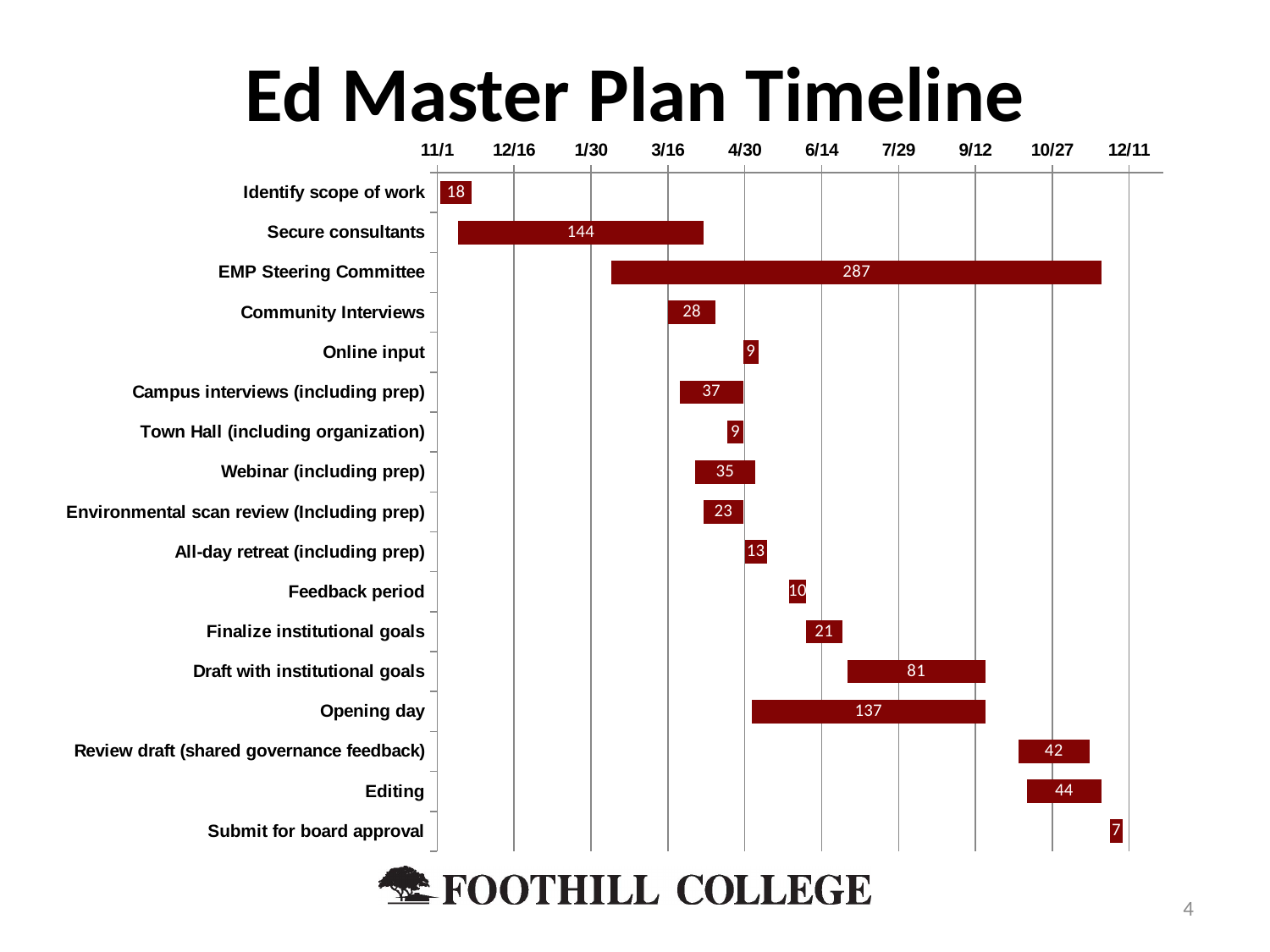
What is the value shown for EMP Steering Committee? 287 What is the difference between the values for Opening day and Draft with institutional goals? 56 What kind of chart is shown on the slide? Bar chart How many tasks are listed on the chart? 17 What is the value shown for Review draft (shared governance feedback)? 42 What is the value shown for Secure consultants? 144 Which has a larger value, Campus interviews (including prep) or Webinar (including prep)? Campus interviews (including prep) What is the value shown for Opening day? 137 Which task has the largest value? EMP Steering Committee Which task has the smallest value? Submit for board approval What is the difference between the values for Editing and Review draft (shared governance feedback)? 2 What is the title of the chart? Ed Master Plan Timeline